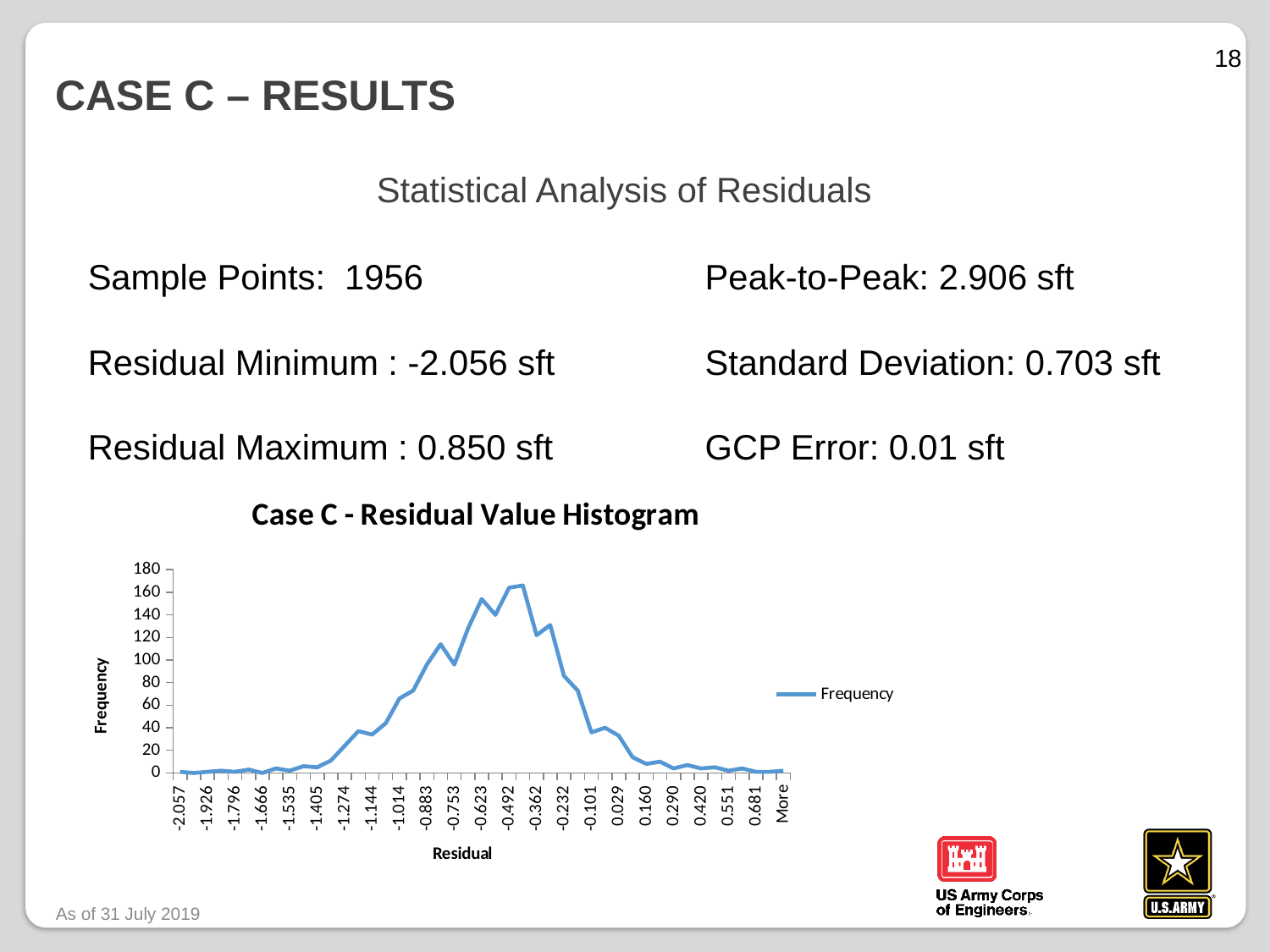
What is the label of the vertical axis of the chart? Frequency Is the highest frequency value on the chart greater or less than 140? greater Do the frequency values rise or fall along the x axis from residual -0.362 to 0.681? fall How many series does the legend of the Case C - Residual Value Histogram list? 1 What is the title of the chart on the slide? Case C - Residual Value Histogram Is the frequency at residual -2.057 greater or less than 20? less Do the frequency values rise or fall along the x axis from residual -1.405 to -0.492? rise Is the frequency at residual -0.753 greater or less than 120? less Which has the larger frequency, residual -0.492 or residual 0.160? -0.492 What kind of chart is the Case C - Residual Value Histogram? line chart